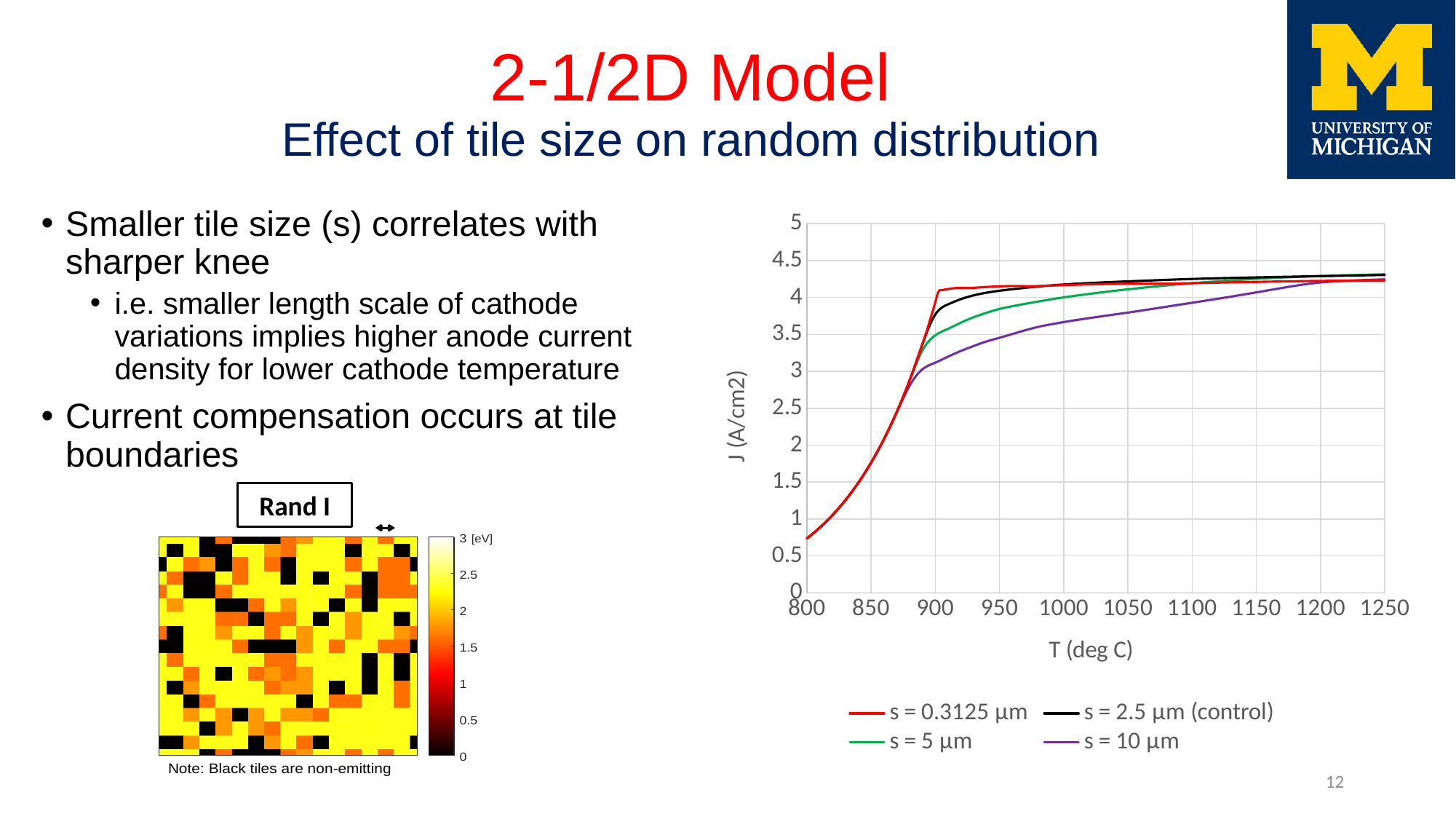
In the line chart, is the value of the s = 0.3125 µm series at T = 950 deg C greater or less than 4? greater In the line chart, which series has the highest J value at T = 950 deg C? s = 0.3125 µm How many series does the legend of the line chart list? 4 In the line chart, is the value of the s = 0.3125 µm series at T = 1250 deg C greater or less than 4.5? less In the line chart, is the value of the s = 10 µm series at T = 1000 deg C greater or less than 4? less In the line chart, at T = 1000 deg C, which is larger: the s = 2.5 µm (control) series or the s = 10 µm series? s = 2.5 µm (control) In the line chart, do the J values rise or fall as T increases from 800 to 1250 deg C? rise What kind of chart is the chart on the right of the slide? line chart What is the label of the y axis of the line chart? J (A/cm2) In the line chart, which series has the lowest J value at T = 1000 deg C? s = 10 µm Which series in the line chart is labelled as the control? s = 2.5 µm (control)